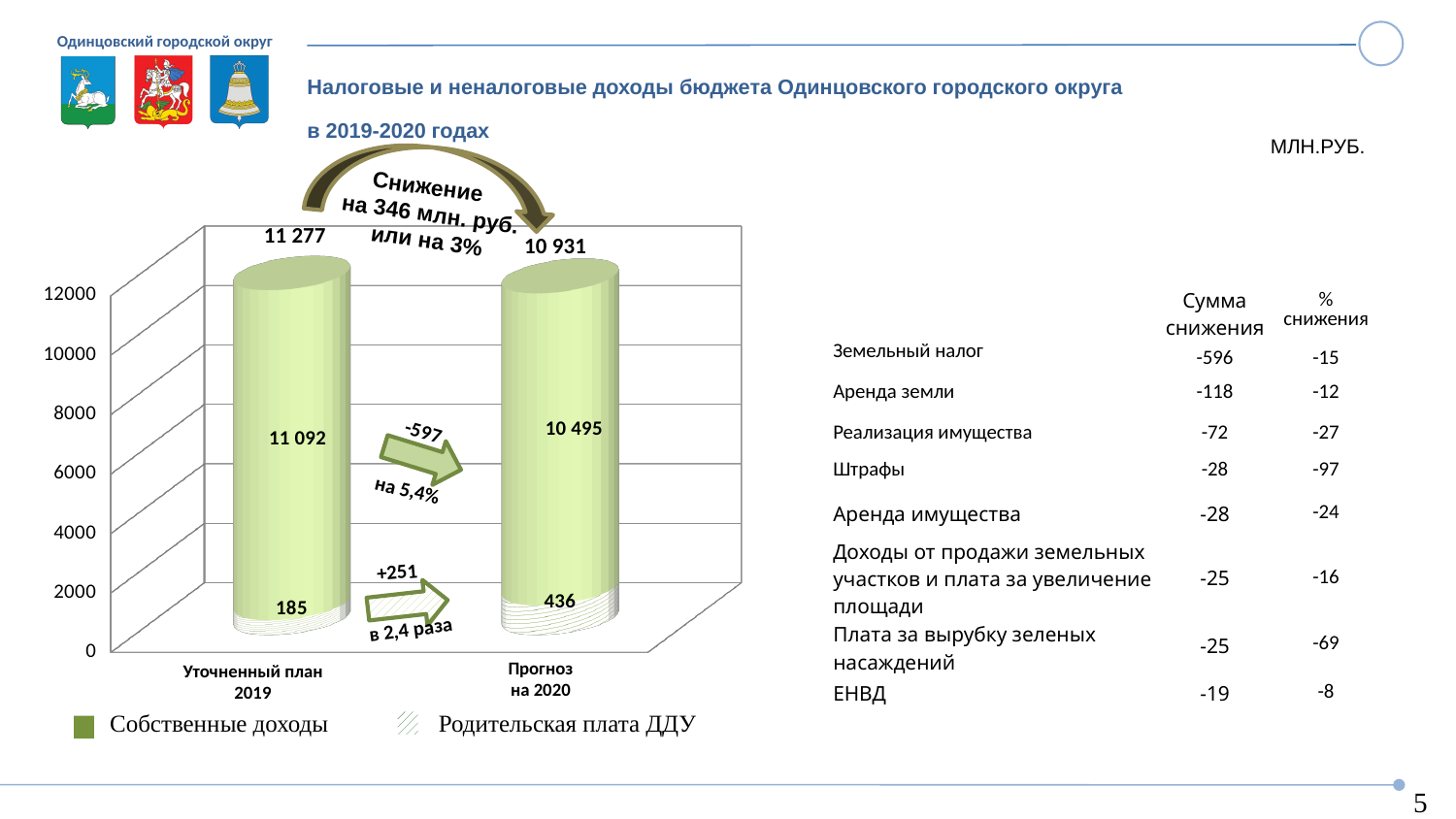
What is the value of Собственные доходы for Прогноз на 2020? 10 495 What is the difference between the Собственные доходы values for Уточненный план 2019 and Прогноз на 2020? 597 What is the difference between the Родительская плата ДДУ values for Прогноз на 2020 and Уточненный план 2019? 251 How many categories are shown on the x axis of the chart? 2 What is the value of Собственные доходы for Уточненный план 2019? 11 092 What is the value of Родительская плата ДДУ for Уточненный план 2019? 185 Which category has the higher value for Собственные доходы, Уточненный план 2019 or Прогноз на 2020? Уточненный план 2019 How many series does the chart legend list? 2 What kind of chart is shown on the slide? Bar chart What is the total of the stacked bar for Прогноз на 2020? 10 931 What is the value of Родительская плата ДДУ for Прогноз на 2020? 436 What is the total of the stacked bar for Уточненный план 2019? 11 277